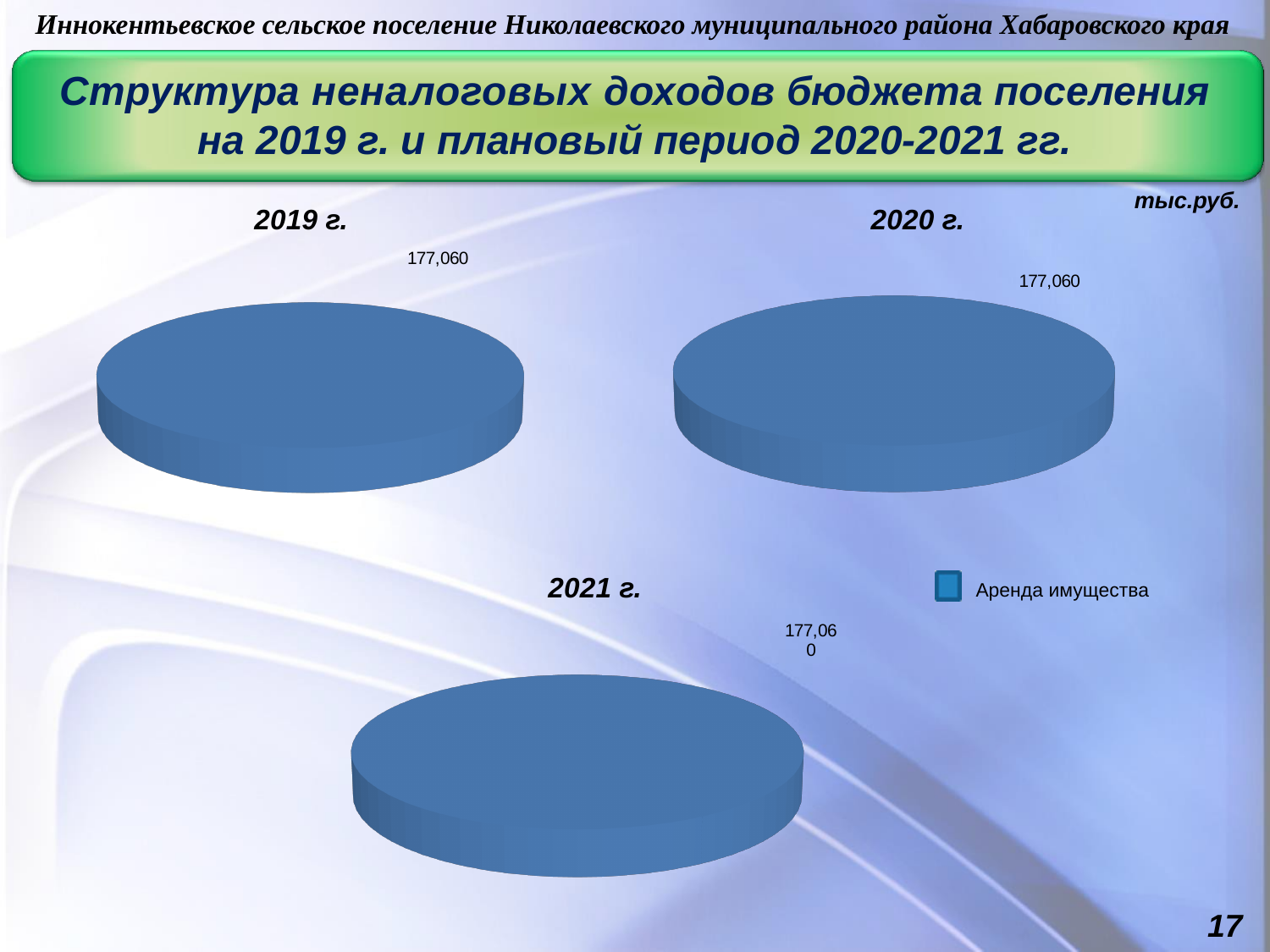
What unit of measurement is indicated for the charts on the slide? тыс.руб. What is the difference between the Аренда имущества value in the chart titled "2019 г." and the chart titled "2021 г."? 0 How many slices does the chart titled "2021 г." have? 1 Is the value for Аренда имущества in the chart titled "2019 г." larger than, smaller than, or equal to the value in the chart titled "2020 г."? equal How many entries does the legend list? 1 What kind of chart is the chart titled "2019 г."? pie chart In the chart titled "2020 г.", what value is shown for Аренда имущества? 177,060 In the chart titled "2021 г.", what value is shown for Аренда имущества? 177,060 What share of the pie does Аренда имущества take in the chart titled "2020 г."? 100% How many pie charts are on the slide? 3 In the chart titled "2019 г.", what value is shown for Аренда имущества? 177,060 What is the legend entry shown on the slide? Аренда имущества